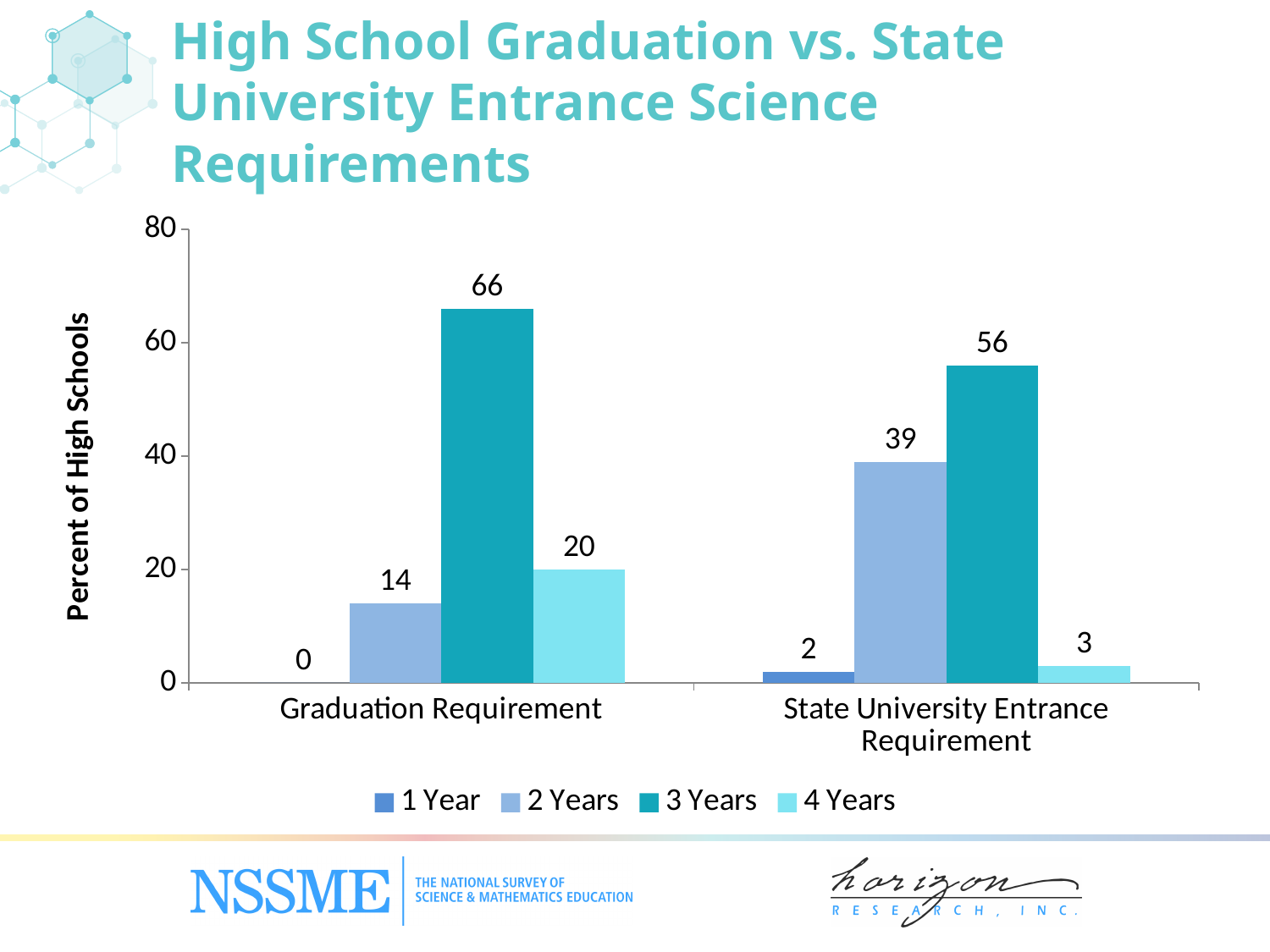
What is the value for 4 Years under State University Entrance Requirement? 3 What is the value for 2 Years under State University Entrance Requirement? 39 What is the difference between the 3 Years values for Graduation Requirement and State University Entrance Requirement? 10 How many series does the legend list? 4 Which series has the highest value under State University Entrance Requirement? 3 Years What kind of chart is shown on the slide? Bar chart What is the label of the y axis? Percent of High Schools How many categories are shown on the x axis? 2 Which is larger: the 2 Years value for Graduation Requirement or for State University Entrance Requirement? State University Entrance Requirement What is the value for 3 Years under Graduation Requirement? 66 What is the value for 1 Year under Graduation Requirement? 0 Which series has the lowest value under Graduation Requirement? 1 Year